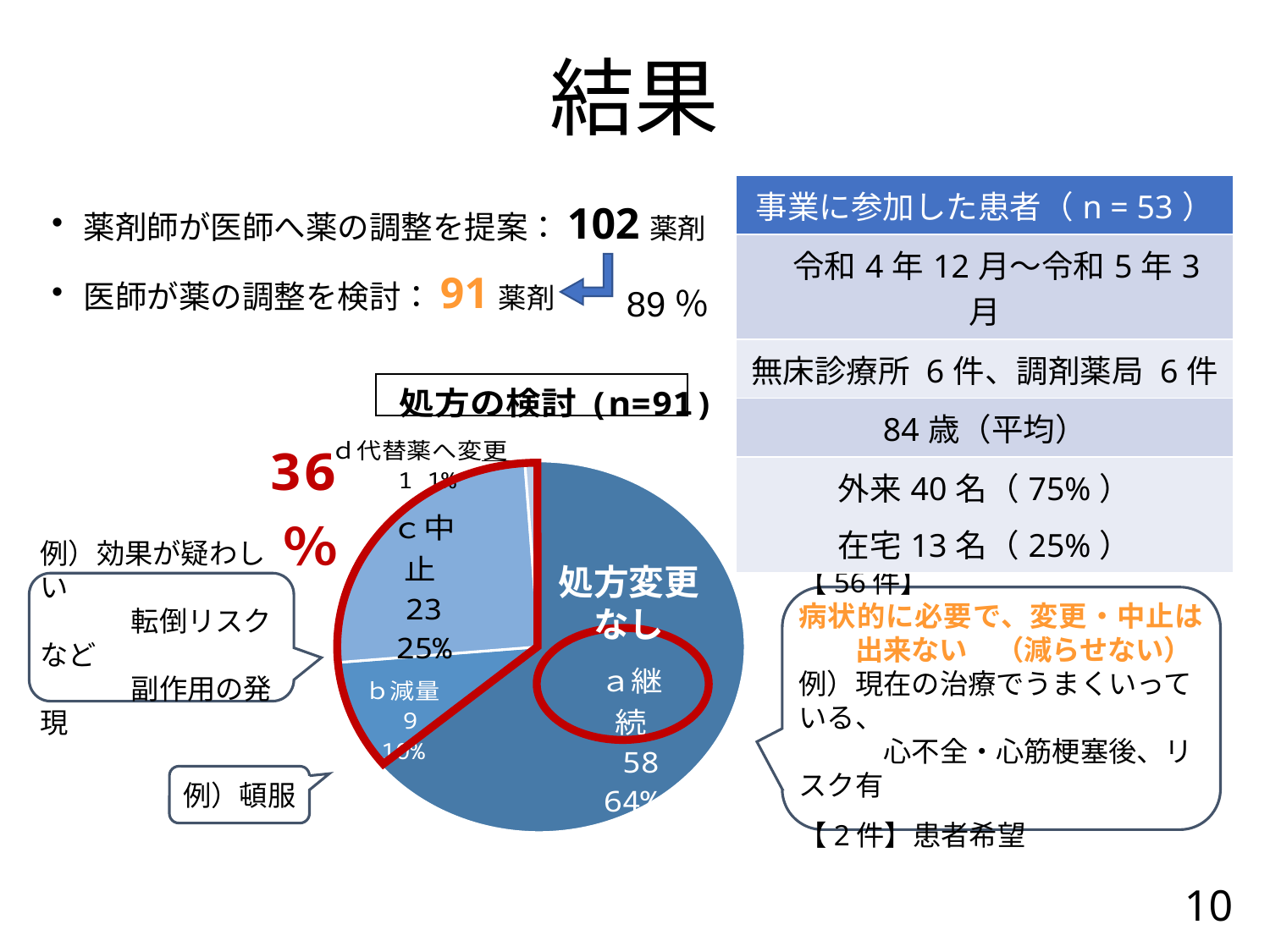
Which category has the smallest slice in the pie chart? d 代替薬へ変更 What is the value for d 代替薬へ変更 in the pie chart? 1 What is the difference between the values for a 継続 and c 中止 in the pie chart? 35 What is the title of the pie chart? 処方の検討（n=91） How many slices does the pie chart have? 4 What percentage share does a 継続 have in the pie chart? 64% What is the value for b 減量 in the pie chart? 9 What is the value for c 中止 in the pie chart? 23 Which category has the largest slice in the pie chart? a 継続 What percentage share does c 中止 have in the pie chart? 25% What type of chart is shown on the slide? pie chart What is the value for a 継続 in the pie chart? 58